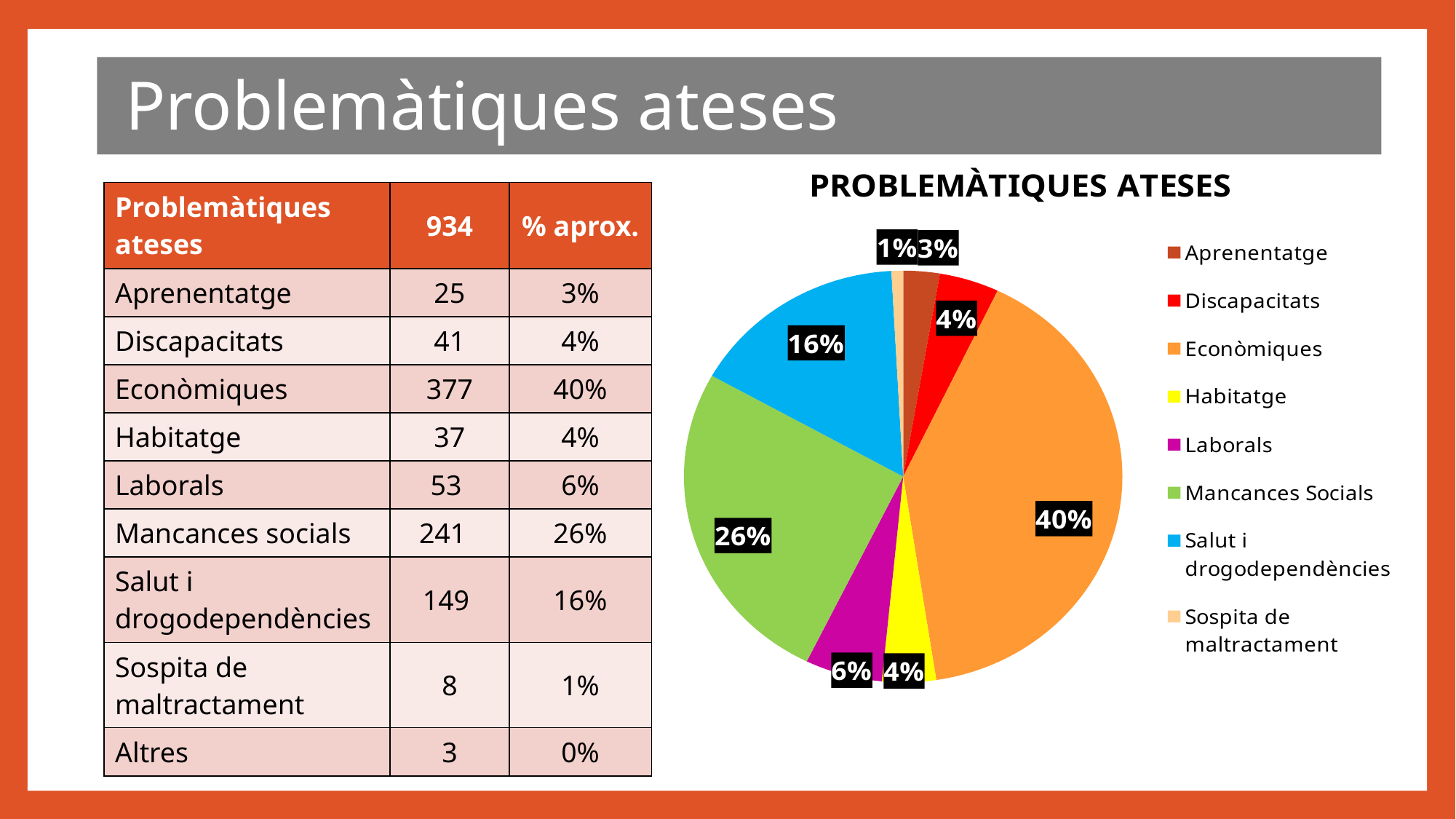
What percentage does the Laborals slice show in the pie chart? 6% Which category has the largest slice in the pie chart? Econòmiques What percentage does the Mancances Socials slice show in the pie chart? 26% What is the title of the chart? PROBLEMÀTIQUES ATESES What type of chart is shown on the slide? Pie chart What percentage does the Salut i drogodependències slice show in the pie chart? 16% Which category has the smallest slice in the pie chart? Sospita de maltractament How many categories does the legend of the pie chart list? 8 Which slice is larger, Mancances Socials or Salut i drogodependències? Mancances Socials By how many percentage points is the Econòmiques slice larger than the Mancances Socials slice? 14 percentage points What percentage does the Econòmiques slice show in the pie chart? 40% What percentage does the Aprenentatge slice show in the pie chart? 3%